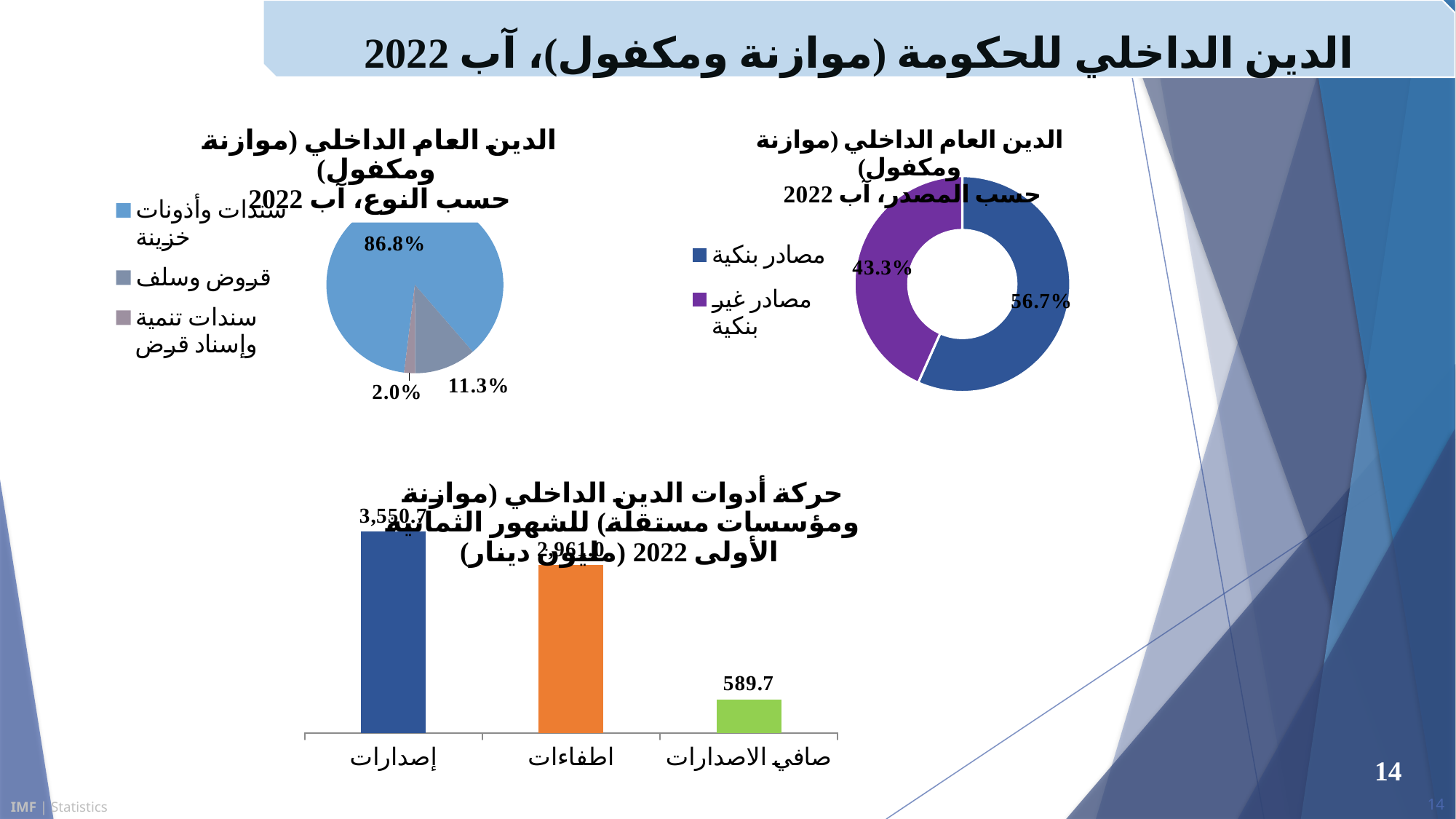
In the donut chart by source (حسب المصدر), what share is shown for مصادر بنكية? 56.7% In the pie chart by type (حسب النوع), how many categories does the legend list? 3 In the pie chart by type (حسب النوع), what share is shown for سندات وأذونات خزينة? 86.8% In the bottom bar chart (حركة أدوات الدين الداخلي), what is the value for صافي الاصدارات? 589.7 In the donut chart by source (حسب المصدر), which source has the larger share, مصادر بنكية or مصادر غير بنكية? مصادر بنكية In the pie chart by type (حسب النوع), what share is shown for قروض وسلف? 11.3% In the bottom bar chart (حركة أدوات الدين الداخلي), which category has the highest value? إصدارات In the bottom bar chart (حركة أدوات الدين الداخلي), what is the value for إصدارات? 3,550.7 What kind of chart is the bottom chart (حركة أدوات الدين الداخلي)? Bar chart In the pie chart by type (حسب النوع), which category has the smallest share? سندات تنمية وإسناد قرض